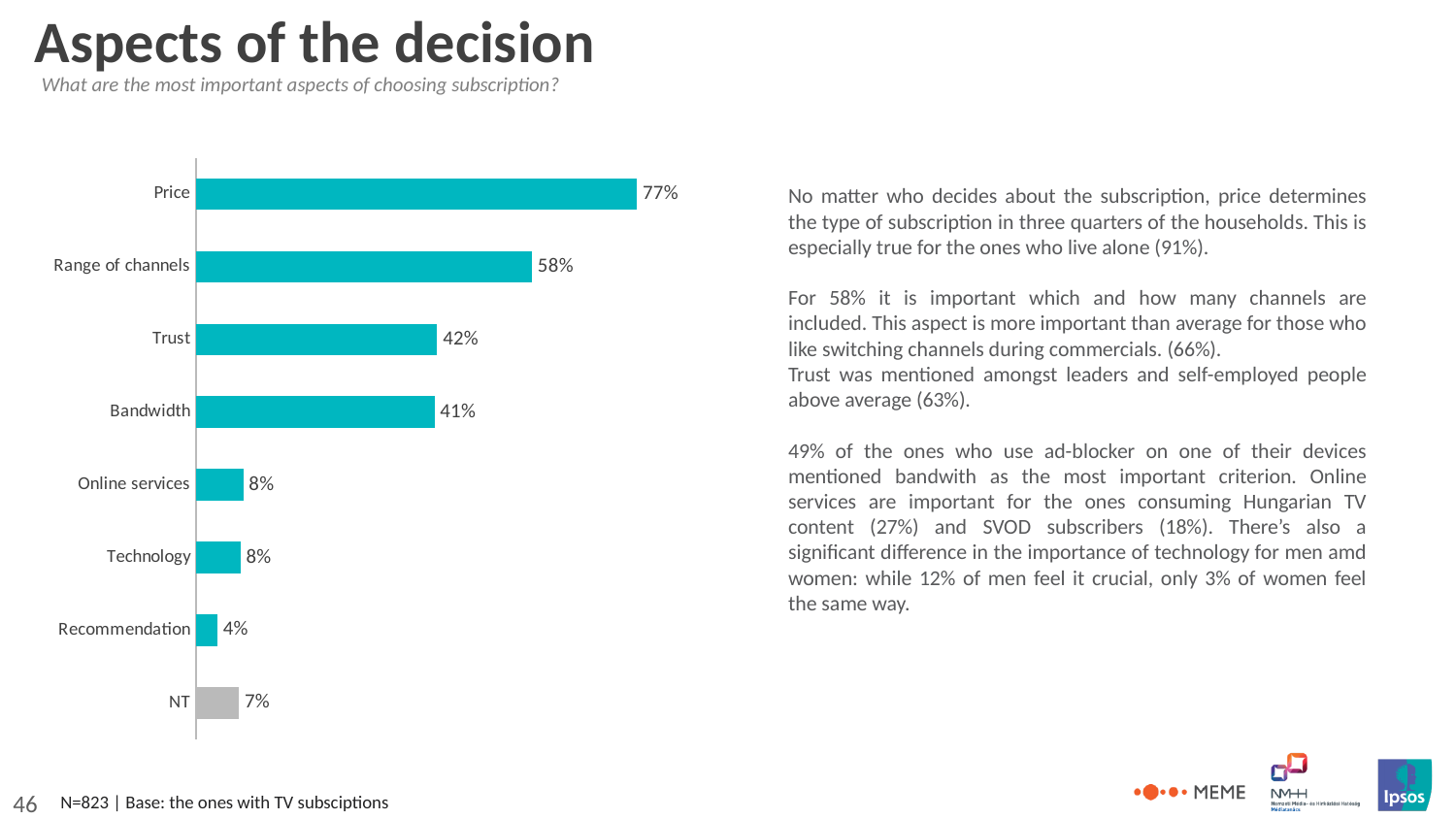
What is the value for Range of channels? 58% Which category has the lowest value? Recommendation Which is larger, the value for Range of channels or the value for Trust? Range of channels How many categories are shown in the chart? 8 What is the value for Price? 77% What kind of chart is shown on the slide? Bar chart What is the difference between the values for Price and Range of channels? 19% What is the difference between the values for Trust and Bandwidth? 1% What is the value for Recommendation? 4% Which category's bar is coloured grey instead of teal? NT What is the value for Bandwidth? 41% Which category has the highest value? Price